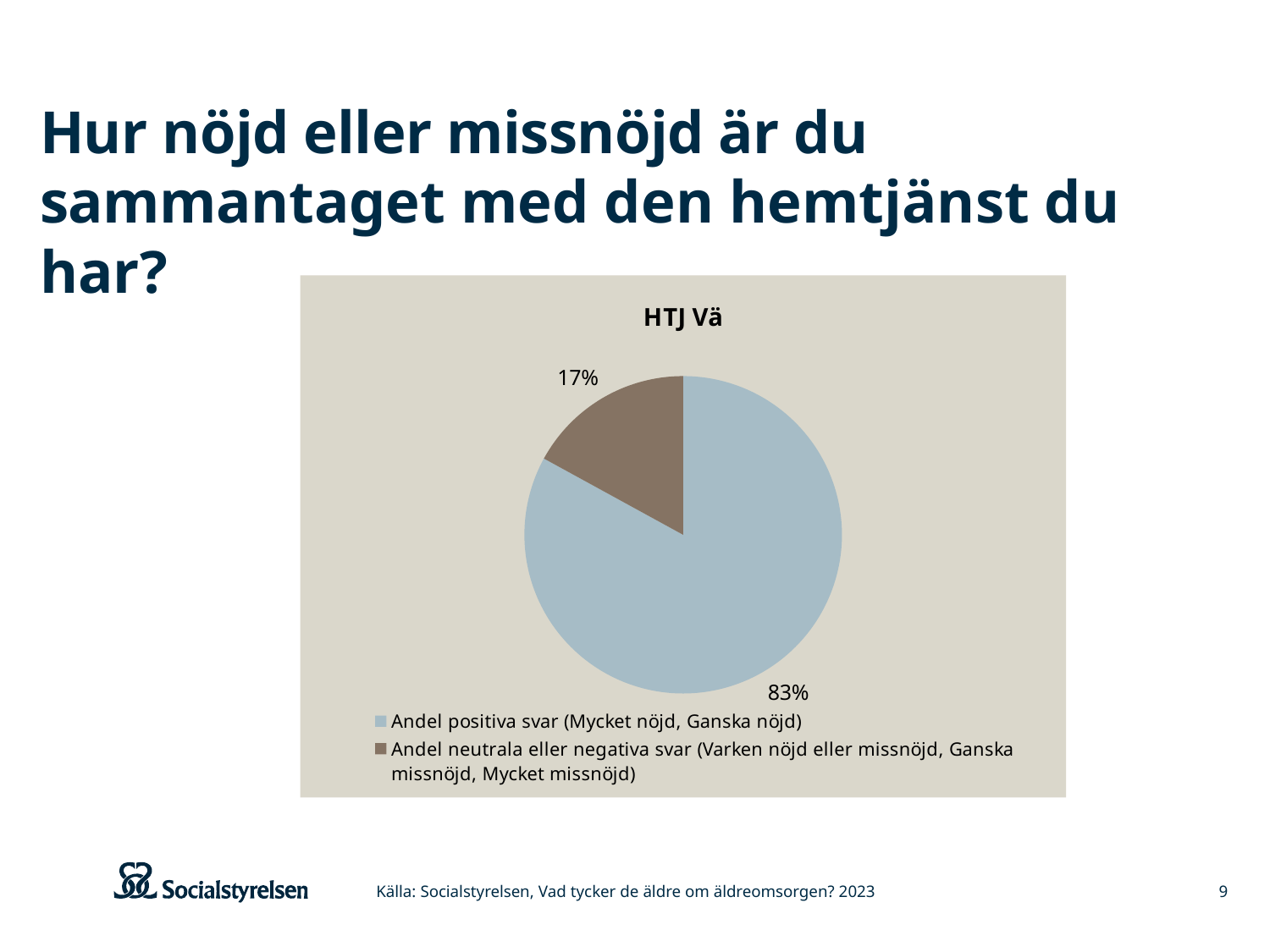
How many slices does the pie chart have? 2 How many entries does the legend list? 2 What colour is the slice for 'Andel positiva svar (Mycket nöjd, Ganska nöjd)'? light blue What share of responses is 'Andel positiva svar (Mycket nöjd, Ganska nöjd)'? 83% What is the title of the chart? HTJ Vä What share of responses is 'Andel neutrala eller negativa svar (Varken nöjd eller missnöjd, Ganska missnöjd, Mycket missnöjd)'? 17% Which slice of the pie is the smallest? Andel neutrala eller negativa svar (Varken nöjd eller missnöjd, Ganska missnöjd, Mycket missnöjd) What kind of chart is shown on the slide? pie chart Which is larger: the share of positive responses or the share of neutral/negative responses? positive responses Which slice of the pie is the largest? Andel positiva svar (Mycket nöjd, Ganska nöjd) What is the difference in percentage points between the positive slice and the neutral/negative slice? 66 percentage points Is the share of positive responses greater or less than 50%? greater